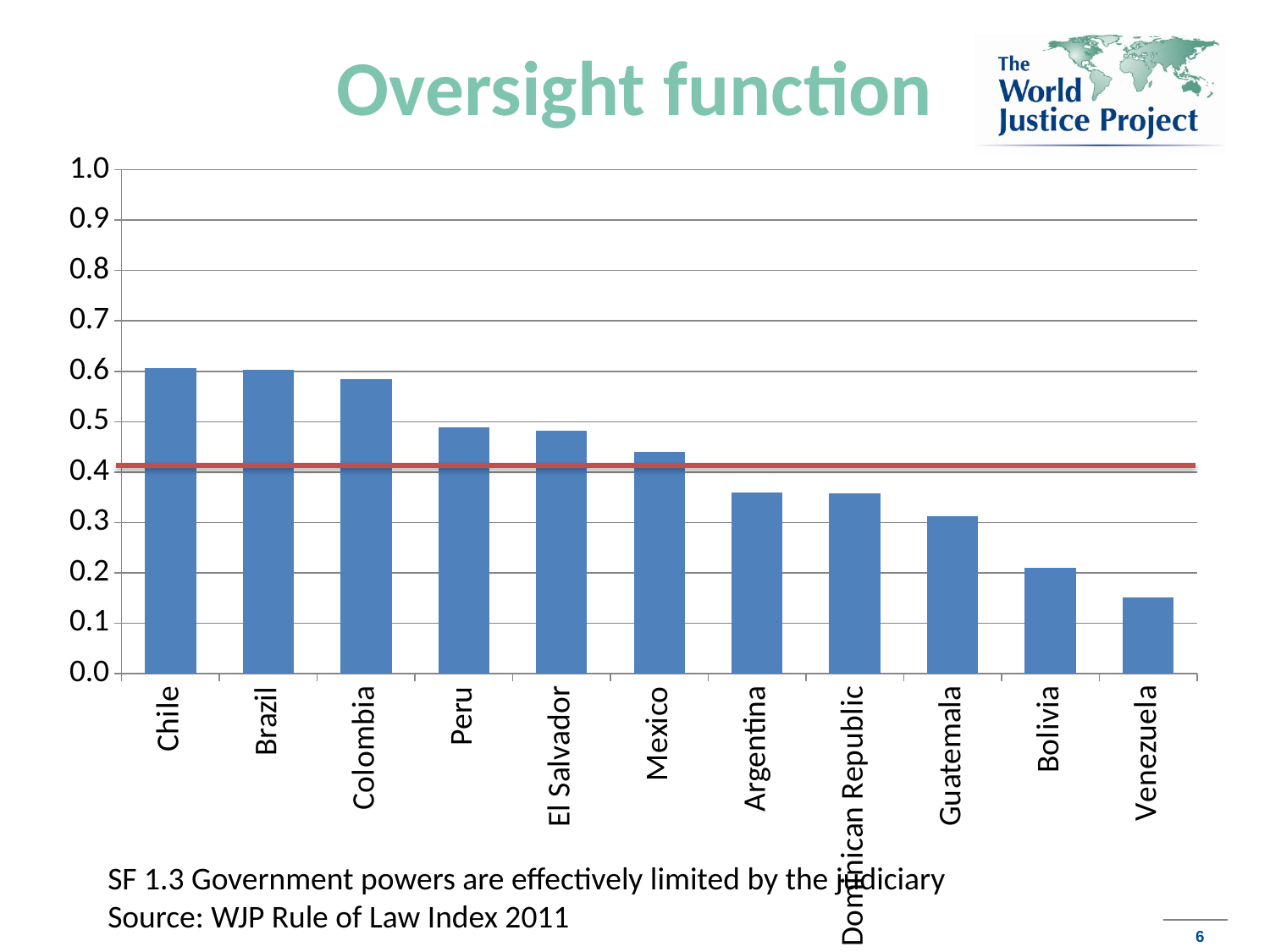
Which has a higher value, Guatemala or Bolivia? Guatemala How many countries are plotted on the chart? 11 Is the value for Guatemala greater or less than 0.4? less What is the title of the slide containing the chart? Oversight function Is the value for Bolivia greater or less than 0.3? less Is the value for Peru greater or less than 0.4? greater Which has a higher value, Colombia or Peru? Colombia Do the bar values rise or fall from left to right across the countries? fall What kind of chart is shown on the slide? bar chart Which country has the lowest value on the chart? Venezuela